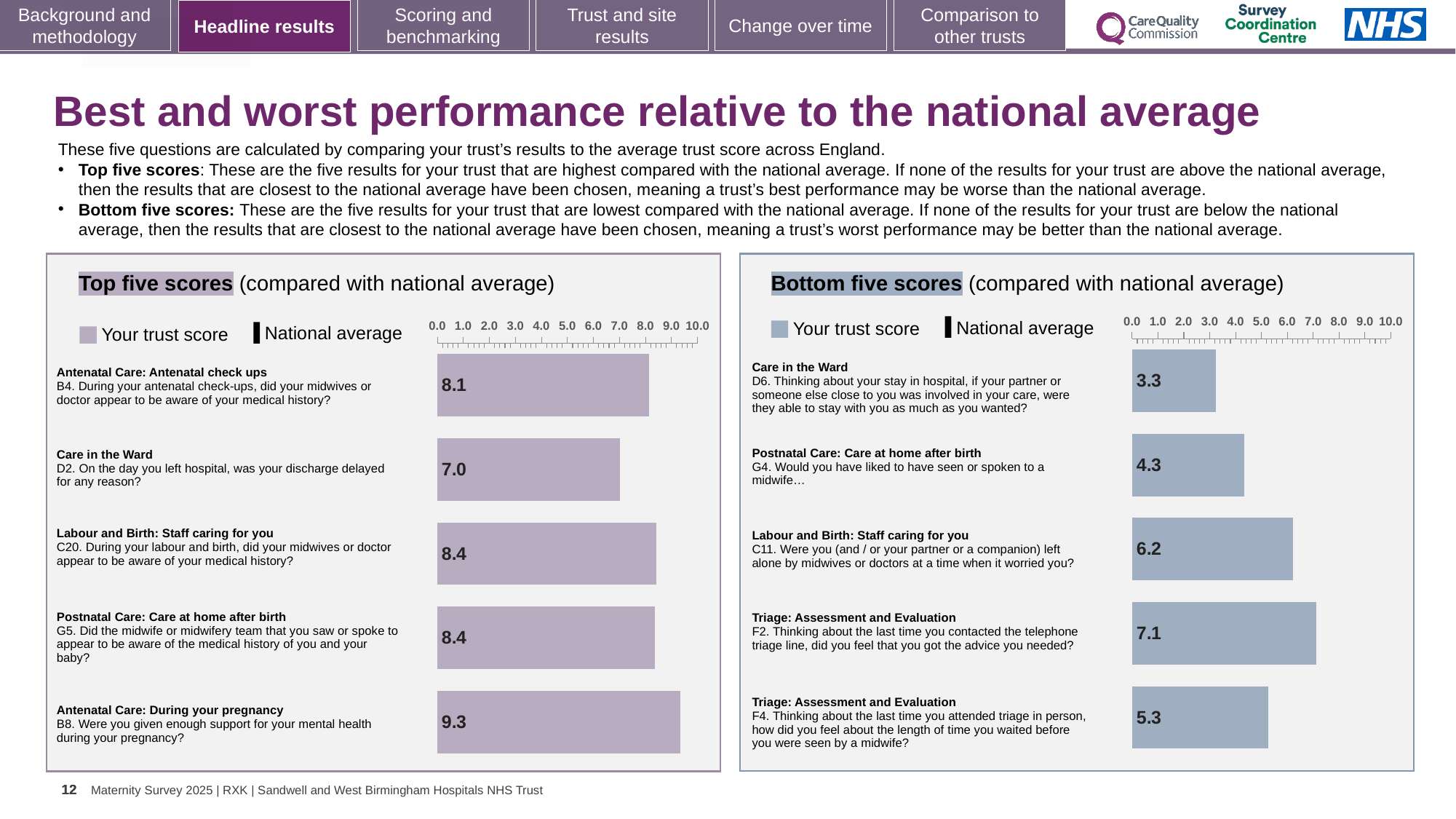
What two entries does the legend of the Bottom five scores chart list? Your trust score; National average In the Top five scores chart, is the trust score for D2 greater or less than 8.0? less What kind of chart is used in the Top five scores panel? Bar chart In the Top five scores chart, what is the difference between the trust scores for B8 and D2? 2.3 How many bars are plotted in the Bottom five scores chart? 5 In the Bottom five scores chart, what is the trust score for F2 (Triage: Assessment and Evaluation, telephone triage line)? 7.1 In the Bottom five scores chart, what is the difference between the trust scores for F2 and D6? 3.8 In the Bottom five scores chart, which has the larger trust score: G4 or F4? F4 (5.3) In the Top five scores chart, which question has the highest trust score? B8 (Antenatal Care: During your pregnancy), 9.3 In the Bottom five scores chart, which question has the lowest trust score? D6 (Care in the Ward), 3.3 In the Top five scores chart, which question has the lowest trust score? D2 (Care in the Ward), 7.0 In the Top five scores chart, what is the trust score for B4 (Antenatal Care: Antenatal check ups)? 8.1